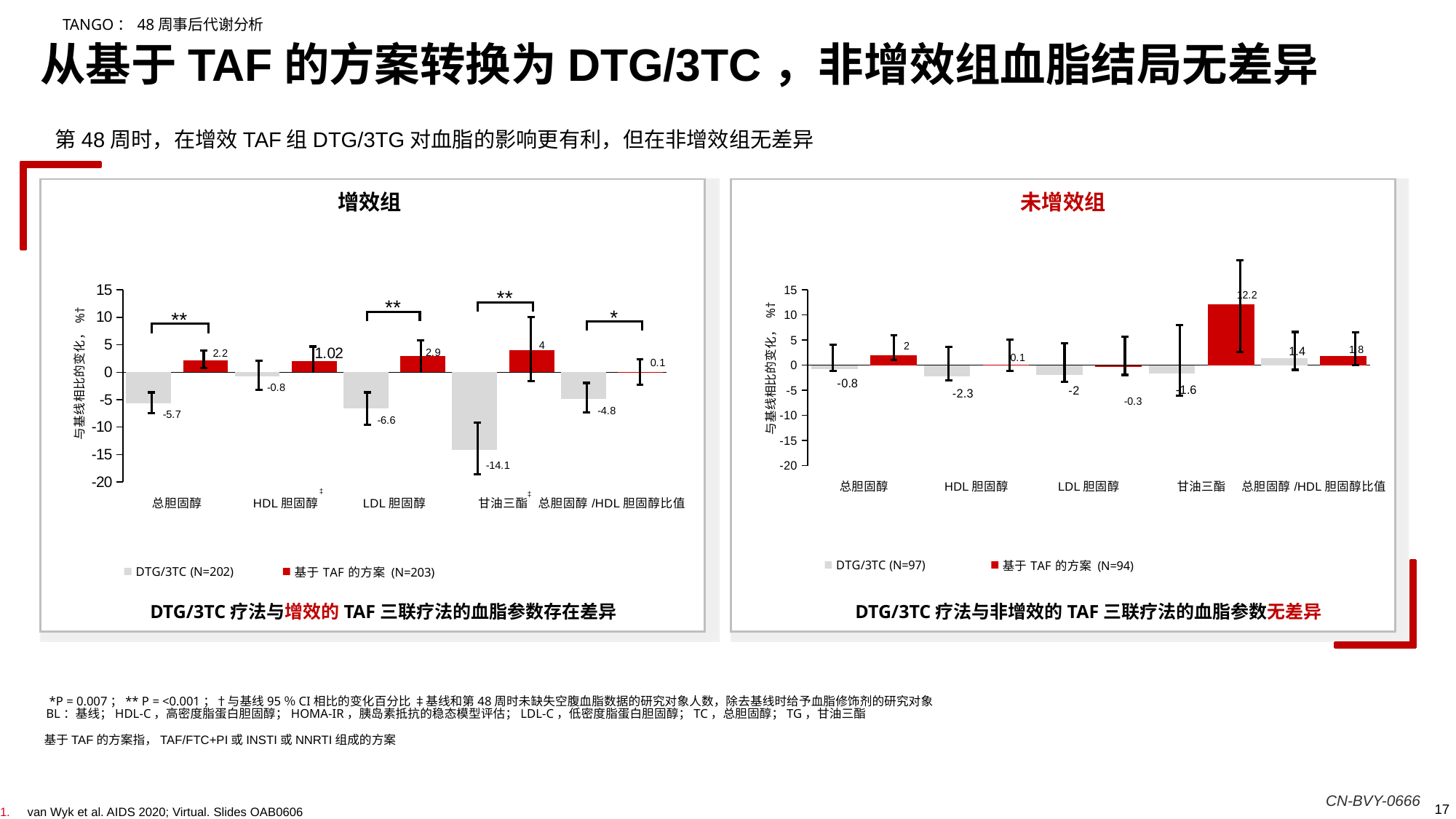
In the 未增效组 chart, what is the value for 基于 TAF 的方案 (N=94) for 甘油三酯? 12.2 What kind of chart is the 增效组 chart? Bar chart In the 未增效组 chart, what is the difference between the 基于 TAF 的方案 and DTG/3TC values for 甘油三酯? 13.8 In the 未增效组 chart, how many categories are shown on the x axis? 5 In the 增效组 chart, what is the value for DTG/3TC (N=202) for 甘油三酯? -14.1 In the 增效组 chart, what is the value for 基于 TAF 的方案 (N=203) for LDL 胆固醇? 2.9 In the 未增效组 chart, which category has the highest value for 基于 TAF 的方案 (N=94)? 甘油三酯 In the 增效组 chart, which category has the lowest value for DTG/3TC (N=202)? 甘油三酯 In the 增效组 chart, how many series does the legend list? 2 In the 未增效组 chart, which is larger for 总胆固醇 /HDL 胆固醇比值: the DTG/3TC value or the 基于 TAF 的方案 value? 基于 TAF 的方案 In the 未增效组 chart, what is the value for DTG/3TC (N=97) for HDL 胆固醇? -2.3 In the 增效组 chart, what is the difference between the 基于 TAF 的方案 and DTG/3TC values for 总胆固醇? 7.9